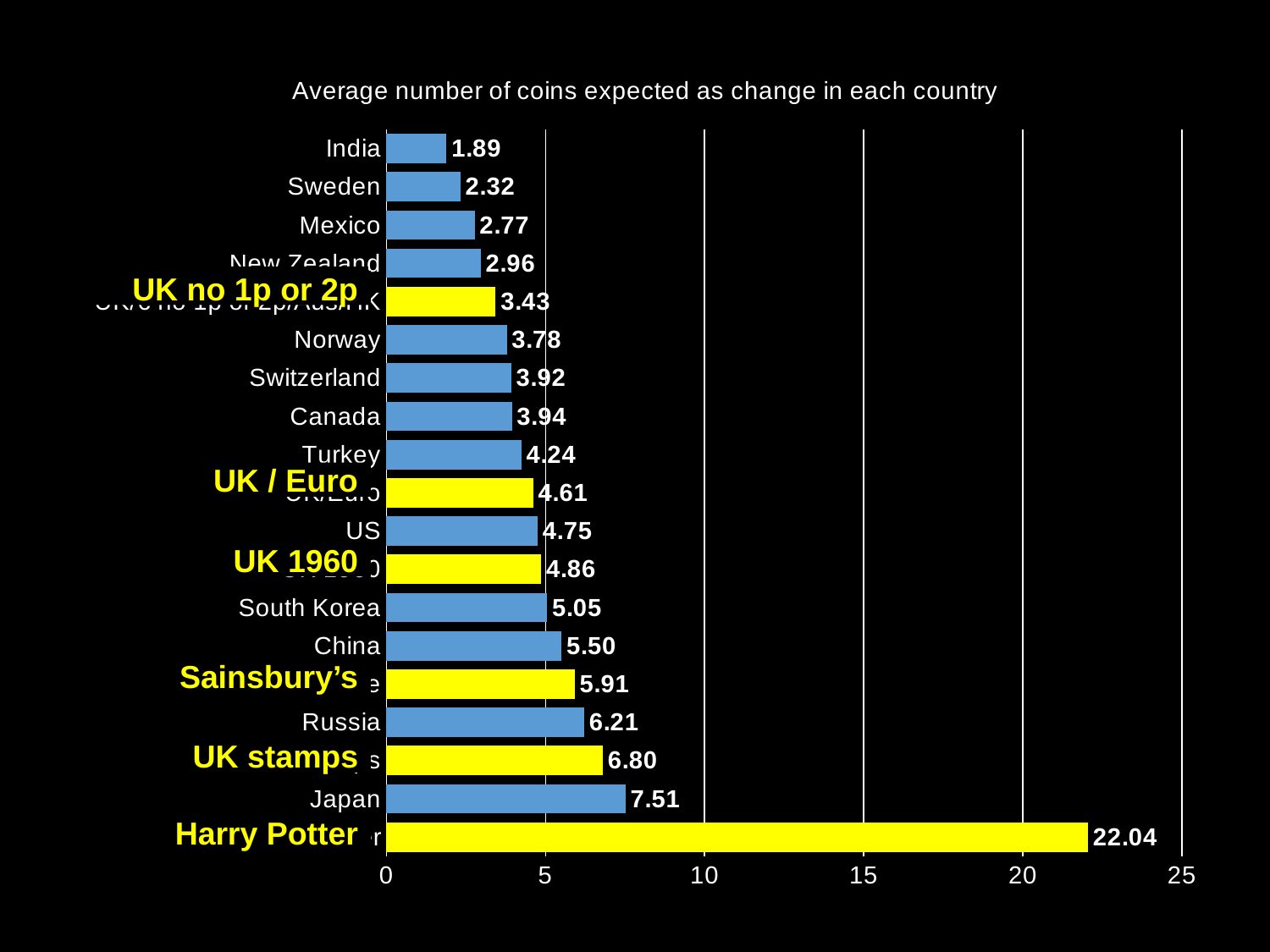
What value is shown for UK stamps? 6.80 Which category has the highest value? Harry Potter What value is shown for the Harry Potter bar? 22.04 What is the difference between the values for Japan and Russia? 1.30 What is the average number of coins expected as change in Japan? 7.51 What is the title of the chart? Average number of coins expected as change in each country Is the value for Harry Potter greater or less than 20? greater Which category has the lowest value? India How many bars are shown in the chart? 19 What type of chart is shown on the slide? Bar chart Which has a larger value, China or US? China What value is shown for Sweden? 2.32